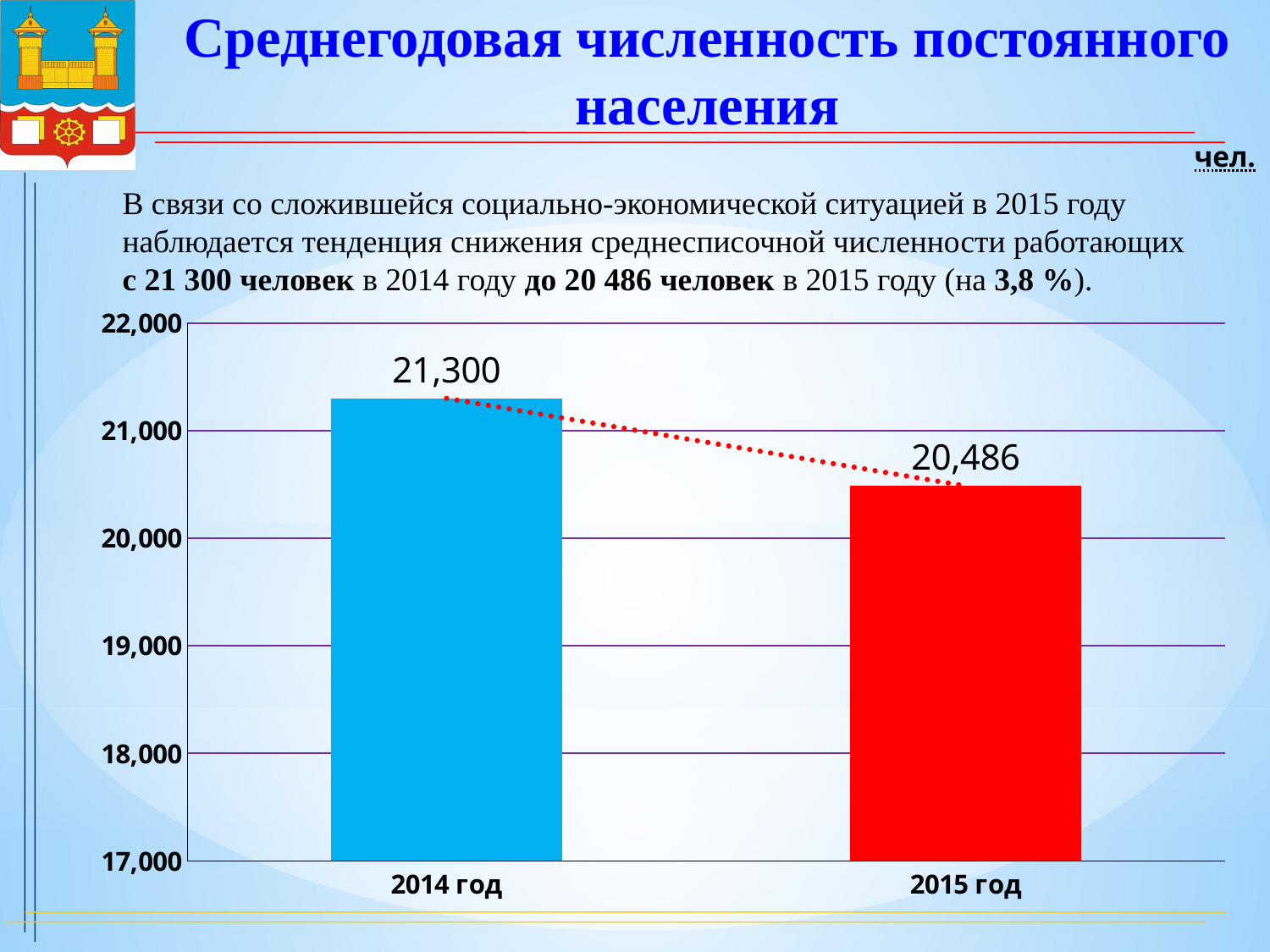
What is the value for 2015 год? 20,486 What is the value for 2014 год? 21,300 Is the value for 2014 год greater or less than 21,000? greater What is the difference between the values for 2014 год and 2015 год? 814 Do the values rise or fall from 2014 год to 2015 год? fall Is the value for 2015 год greater or less than 21,000? less What colour is the bar for 2015 год? red Which year has the higher value? 2014 год How many categories are shown on the x axis? 2 What kind of chart is shown on the slide? bar chart Which year has the lower value? 2015 год Is the value for 2014 год larger or smaller than the value for 2015 год? larger